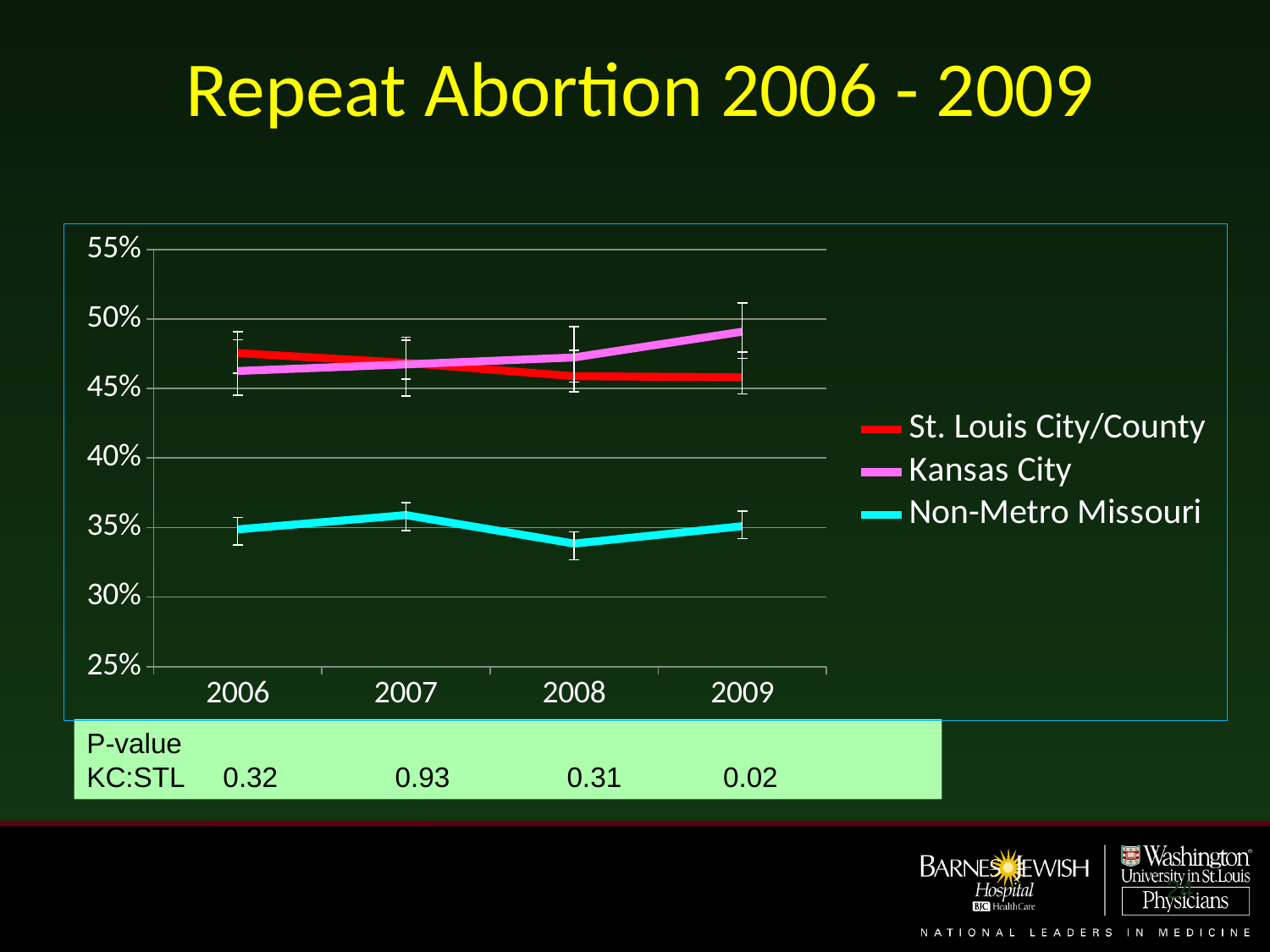
Is the Non-Metro Missouri value for 2008 greater or less than 35%? less Does the St. Louis City/County line rise or fall from 2006 to 2009? Fall How many series does the legend list? 3 Does the Kansas City line rise or fall from 2006 to 2009? Rise Which is larger in 2009, the St. Louis City/County value or the Kansas City value? Kansas City What kind of chart is shown on the slide? Line chart Which series has the highest value in 2009? Kansas City Is the Kansas City value for 2009 greater or less than 50%? less Which series has the lowest values across all years? Non-Metro Missouri In which year is the Non-Metro Missouri value lowest? 2008 How many years are plotted along the x axis? 4 In which year is the Non-Metro Missouri value highest? 2007